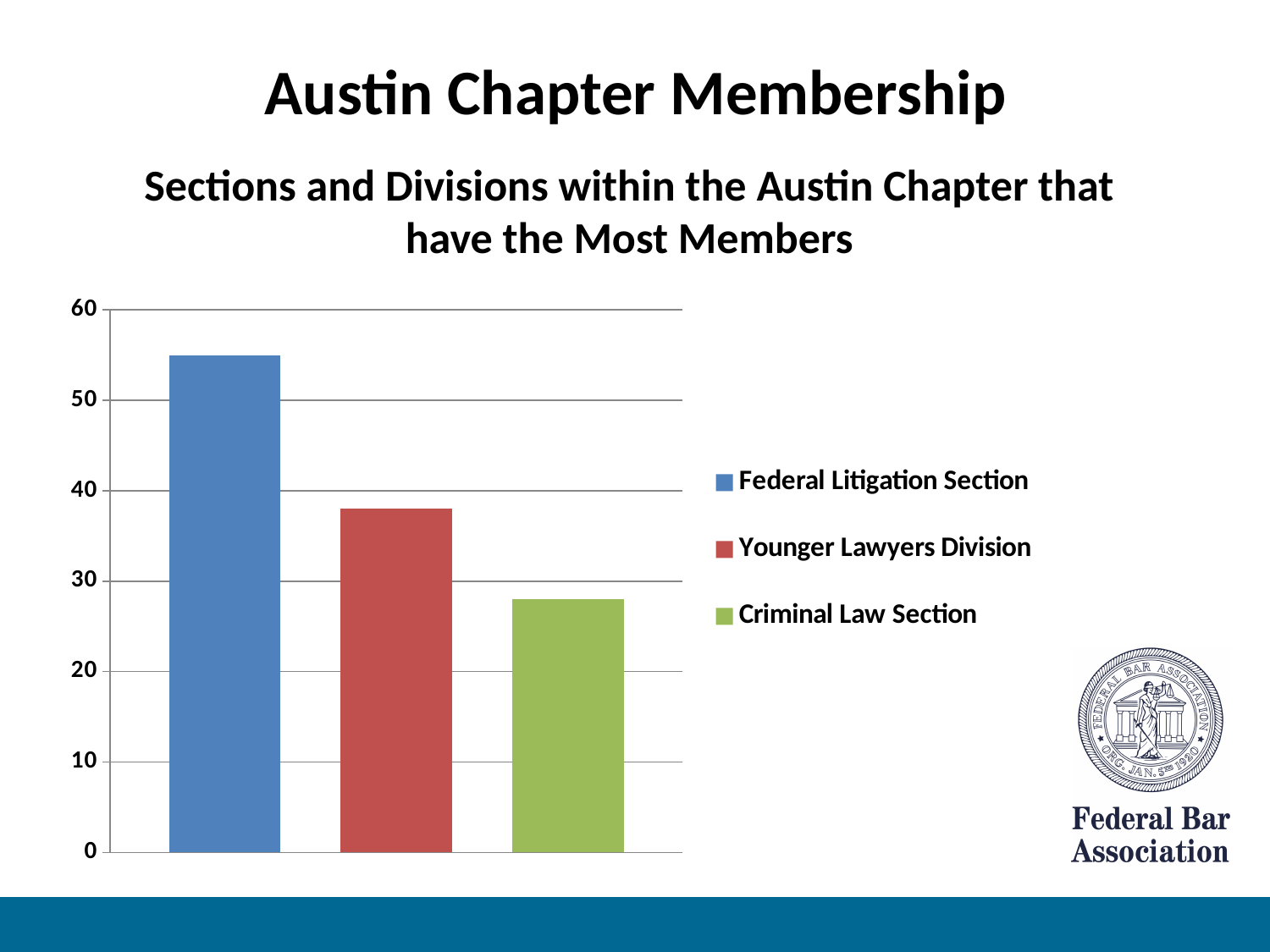
Which has more members, the Younger Lawyers Division or the Criminal Law Section? Younger Lawyers Division What kind of chart is shown on the slide? bar chart Is the value for the Criminal Law Section greater or less than 30? less How many entries does the legend list? 3 What colour is the bar for the Younger Lawyers Division? red Is the value for the Federal Litigation Section greater or less than 50? greater How many bars are plotted in the chart? 3 Is the value for the Criminal Law Section greater or less than 20? greater Which has more members, the Federal Litigation Section or the Younger Lawyers Division? Federal Litigation Section Which section or division has the highest number of members? Federal Litigation Section Which section or division has the lowest number of members? Criminal Law Section